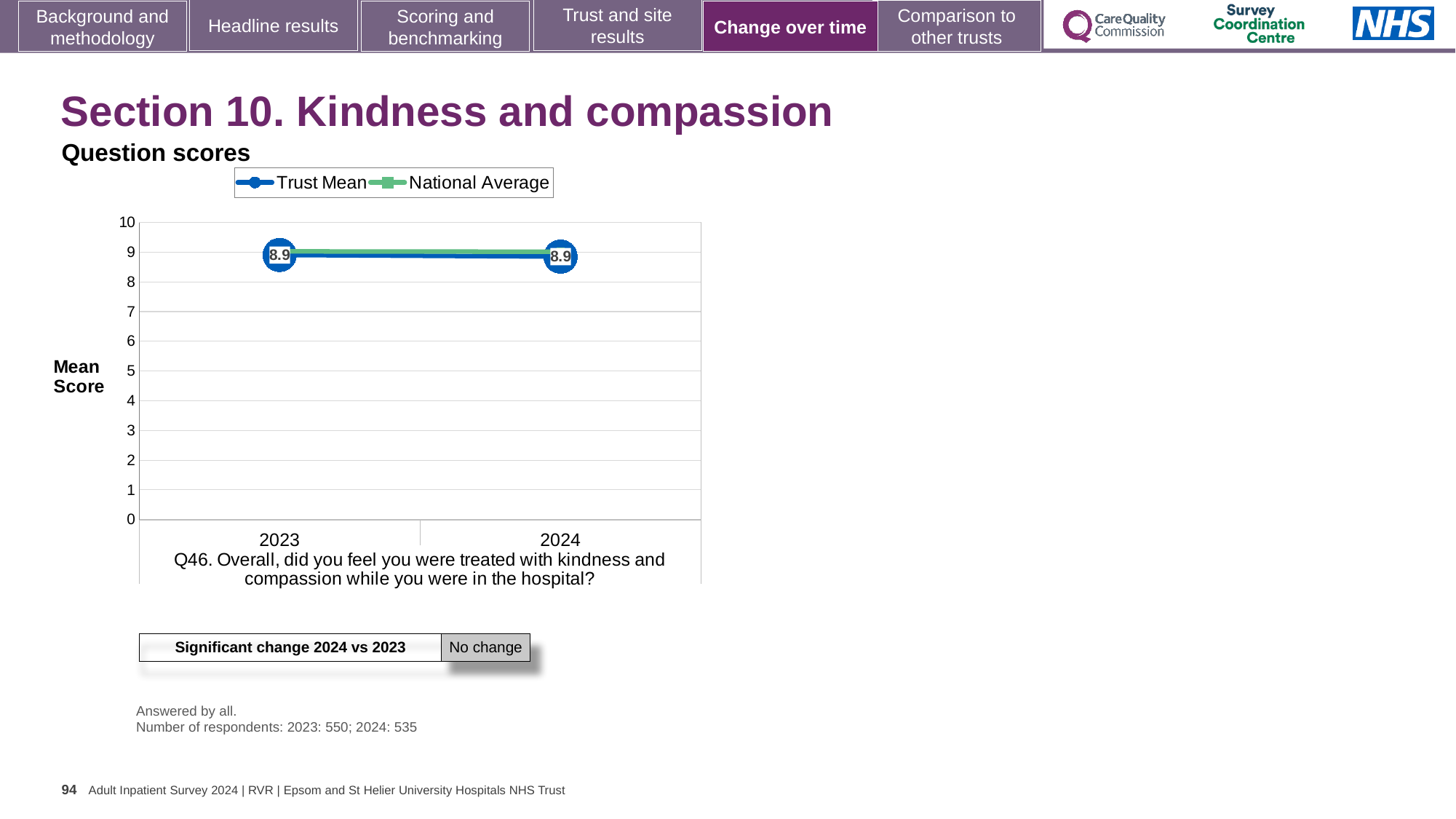
What is the difference between the Trust Mean scores for 2024 and 2023? 0 Does the Trust Mean rise, fall or stay the same from 2023 to 2024? stays the same Is the Trust Mean score for 2023 greater or less than 8? greater What is the Trust Mean score for 2023? 8.9 Which series is shown in green in the legend? National Average Is the National Average for 2024 greater or less than 5? greater What kind of chart is shown on the slide? line chart How many series does the legend list? 2 How many years are plotted on the x axis? 2 What is the maximum value shown on the y axis? 10 What is the label of the y axis? Mean Score What is the Trust Mean score for 2024? 8.9